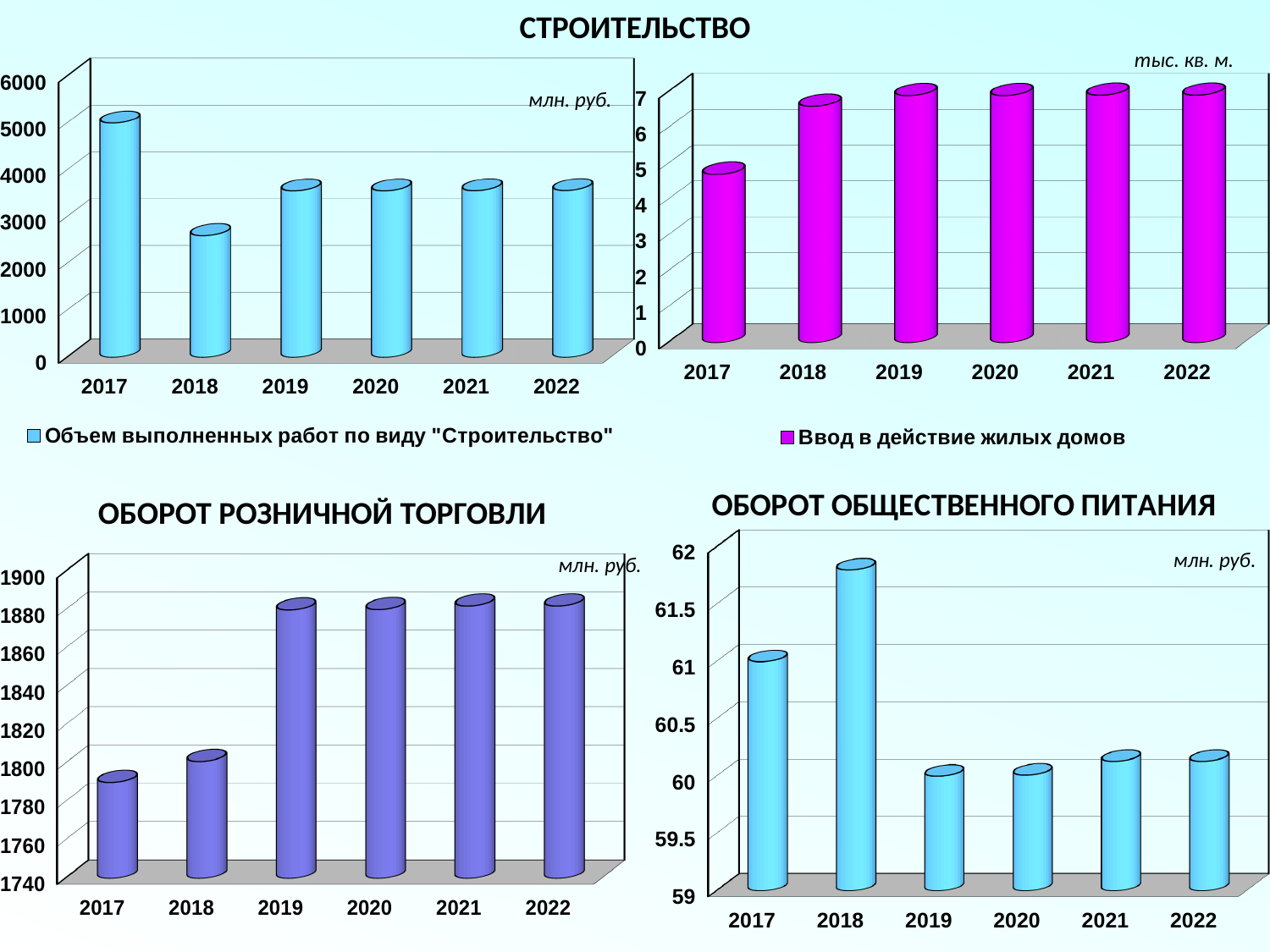
On the top-left chart (Объем выполненных работ по виду "Строительство"), which year has the lowest value? 2018 On the top-right chart (Ввод в действие жилых домов), which is larger, the value for 2017 or the value for 2018? 2018 On the top-left chart (Объем выполненных работ по виду "Строительство"), is the value for 2018 greater or less than 3000? less On the bottom-left chart (ОБОРОТ РОЗНИЧНОЙ ТОРГОВЛИ), which year has the lowest value? 2017 On the top-left chart (Объем выполненных работ по виду "Строительство"), which year has the highest value? 2017 On the bottom-right chart (ОБОРОТ ОБЩЕСТВЕННОГО ПИТАНИЯ), which year has the highest value? 2018 How many years are shown on the x axis of the bottom-right chart (ОБОРОТ ОБЩЕСТВЕННОГО ПИТАНИЯ)? 6 On the top-right chart (Ввод в действие жилых домов), which year has the lowest value? 2017 On the top-left chart (Объем выполненных работ по виду "Строительство"), is the value for 2017 greater or less than 4000? greater On the top-right chart (Ввод в действие жилых домов), is the value for 2017 greater or less than 5? less